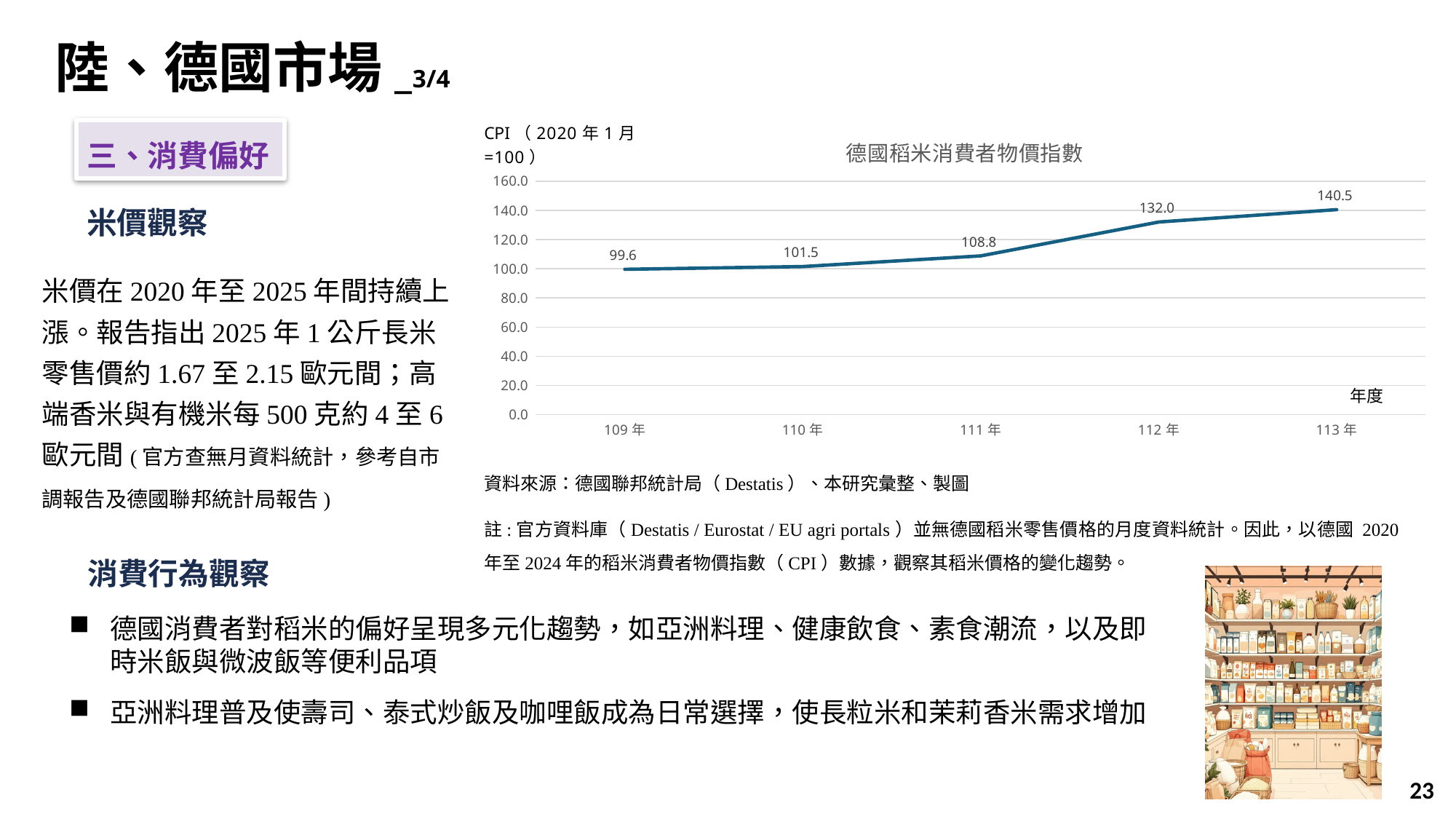
What is the CPI value for 112 年? 132.0 What kind of chart is shown on the slide? Line chart Which year has the lowest CPI value? 109 年 What is the CPI value for 109 年 in the 德國稻米消費者物價指數 chart? 99.6 Which is larger, the CPI value for 110 年 or for 112 年? 112 年 What is the difference between the CPI values for 113 年 and 112 年? 8.5 Which year has the highest CPI value? 113 年 Do the CPI values rise or fall from 109 年 to 113 年? Rise What is the difference between the CPI values for 111 年 and 110 年? 7.3 How many years are plotted on the x axis of the chart? 5 What is the CPI value for 111 年? 108.8 What is the CPI value for 113 年? 140.5